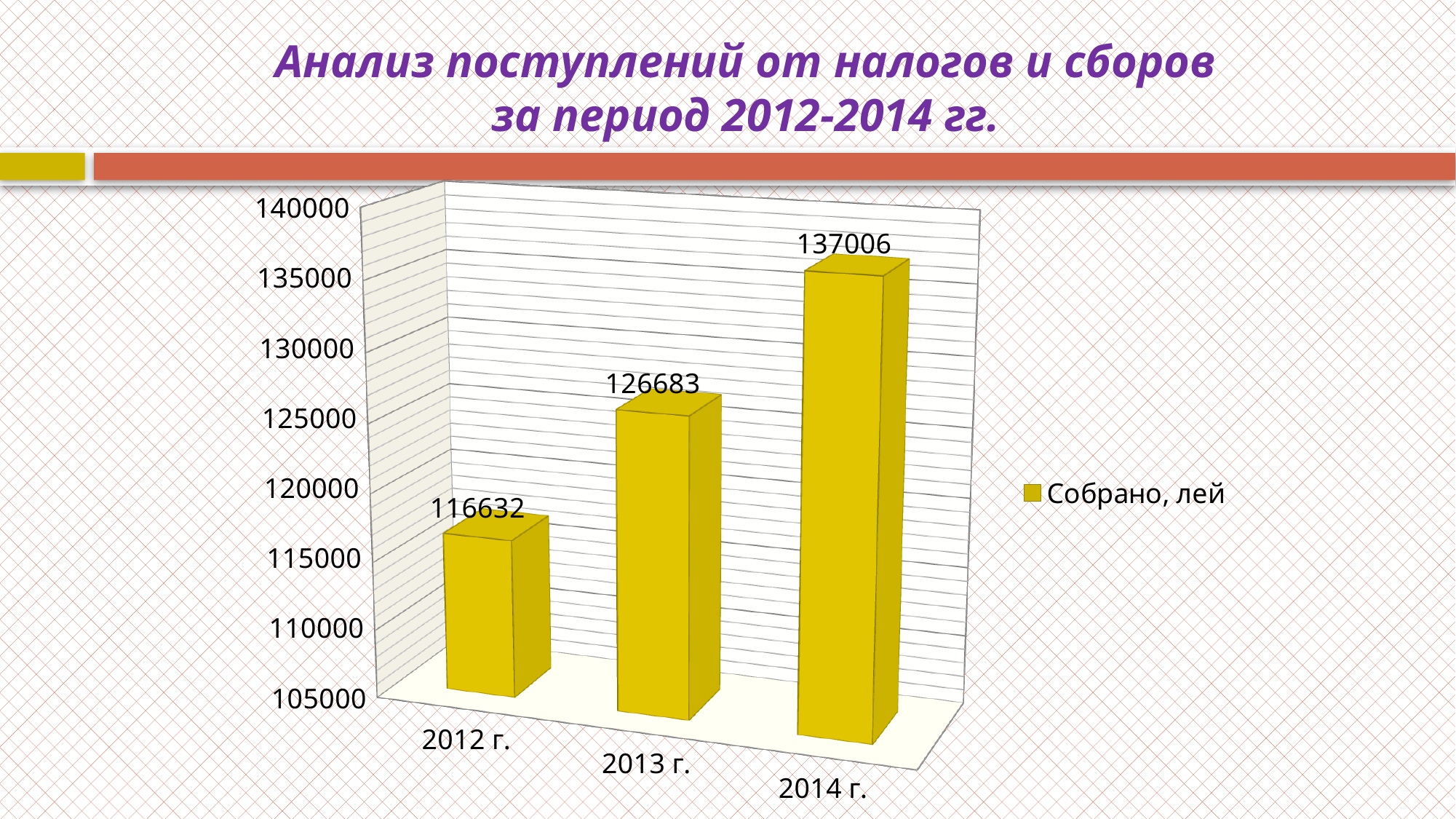
What is the difference between the values for 2013 г. and 2012 г.? 10051 Which year has the highest value? 2014 г. What is the difference between the values for 2014 г. and 2012 г.? 20374 How many categories are shown on the x axis? 3 What is the value for 2013 г.? 126683 What is the value for 2014 г.? 137006 What kind of chart is shown on the slide? bar chart Which year has the lowest value? 2012 г. Is the value for 2013 г. greater or less than 125000? greater What is the value for 2012 г.? 116632 Do the values rise or fall from 2012 г. to 2014 г.? rise Which is larger, the value for 2013 г. or the value for 2014 г.? 2014 г.